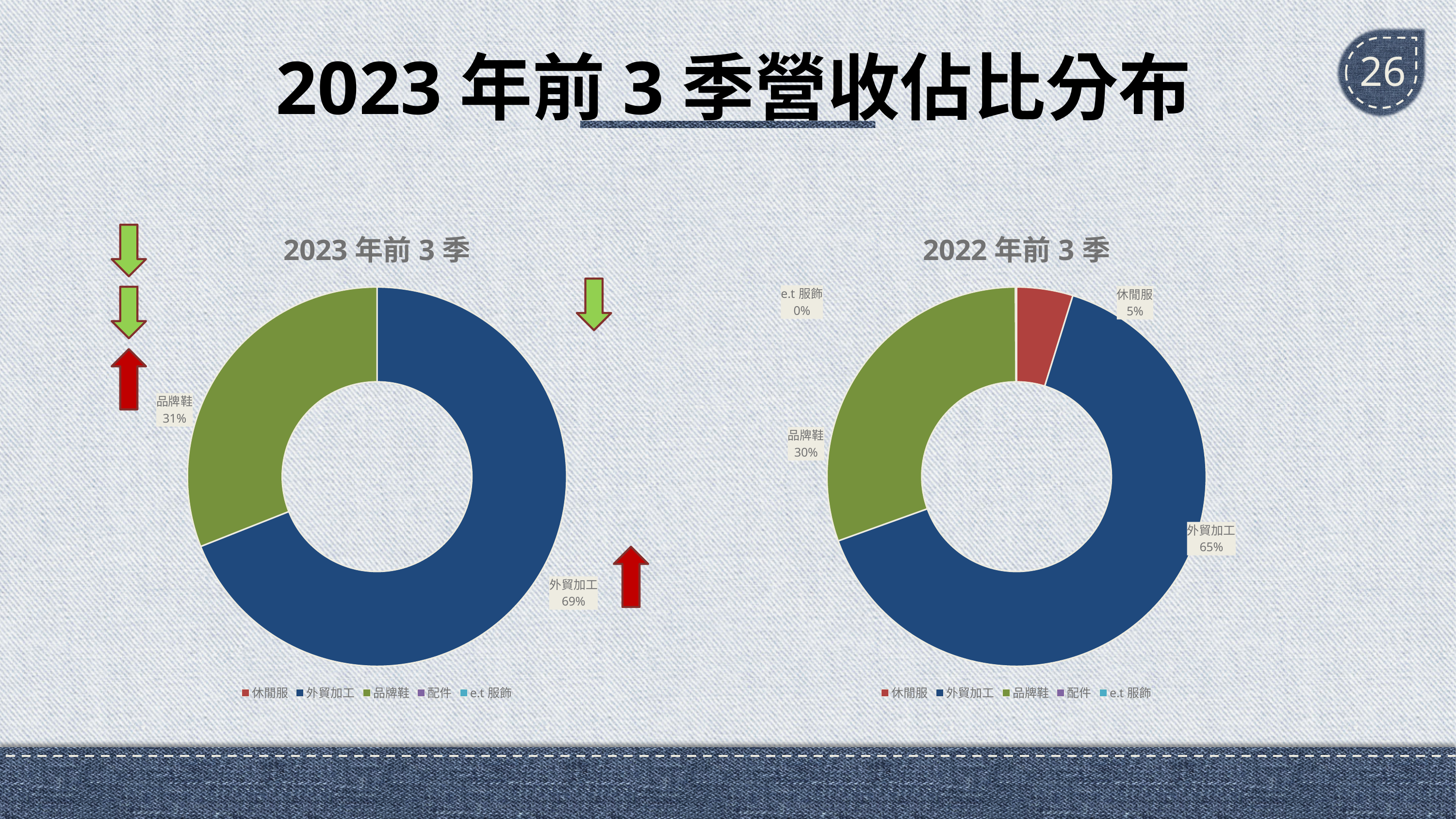
In the 2022 年前 3 季 chart, which labelled category has the largest share? 外貿加工 Is the 品牌鞋 share larger in the 2023 年前 3 季 chart or in the 2022 年前 3 季 chart? 2023 年前 3 季 In the 2022 年前 3 季 chart, what share does 外貿加工 have? 65% In the 2023 年前 3 季 chart, what share does 外貿加工 have? 69% In the 2023 年前 3 季 chart, what share does 品牌鞋 have? 31% In the 2022 年前 3 季 chart, what share does 休閒服 have? 5% How many entries does the legend of the 2023 年前 3 季 chart list? 5 What is the difference between the 外貿加工 share in the 2023 年前 3 季 chart and in the 2022 年前 3 季 chart? 4% In the 2022 年前 3 季 chart, which labelled category has the smallest share? e.t 服飾 What kind of chart is the 2022 年前 3 季 chart? Doughnut (pie) chart In the 2022 年前 3 季 chart, what share does e.t 服飾 have? 0% In the 2022 年前 3 季 chart, what is the difference between the 外貿加工 share and the 品牌鞋 share? 35%